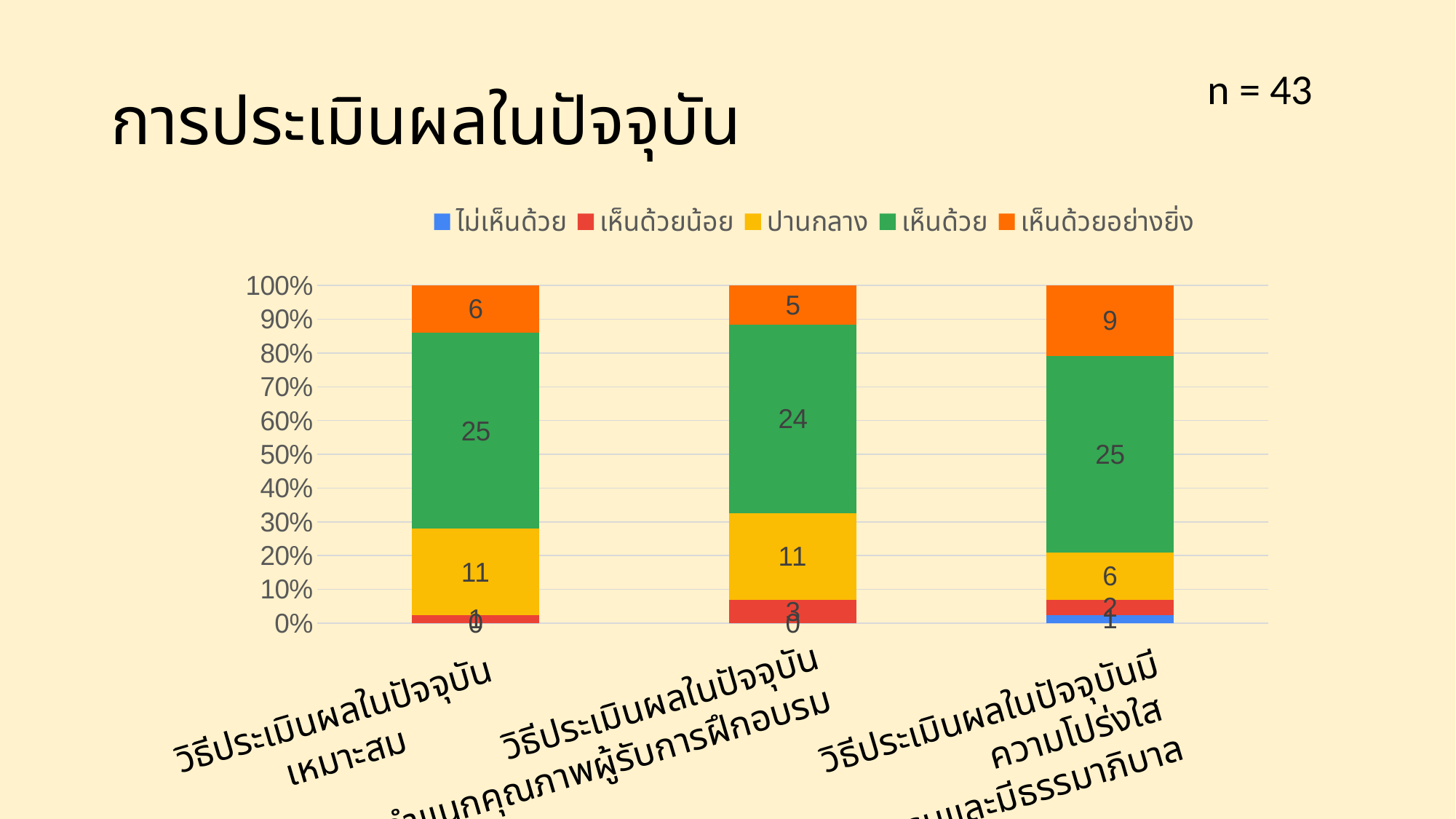
What kind of chart is shown on the slide? stacked bar chart How many series does the legend list? 5 What is the value of เห็นด้วย for the category วิธีประเมินผลในปัจจุบันเหมาะสม? 25 What is the value of ปานกลาง for the leftmost bar (วิธีประเมินผลในปัจจุบันเหมาะสม)? 11 What is the value of เห็นด้วยอย่างยิ่ง for the rightmost bar? 9 Which bar has the lowest value for ปานกลาง? the rightmost bar Is the เห็นด้วย value larger for the leftmost bar or the middle bar? the leftmost bar Which bar has the highest value for เห็นด้วยอย่างยิ่ง? the rightmost bar What is the difference between the เห็นด้วยอย่างยิ่ง values of the rightmost bar and the middle bar? 4 How many categories (bars) are plotted in the chart? 3 What is the value of เห็นด้วยน้อย for the middle bar? 3 What is the title of the chart on the slide? การประเมินผลในปัจจุบัน